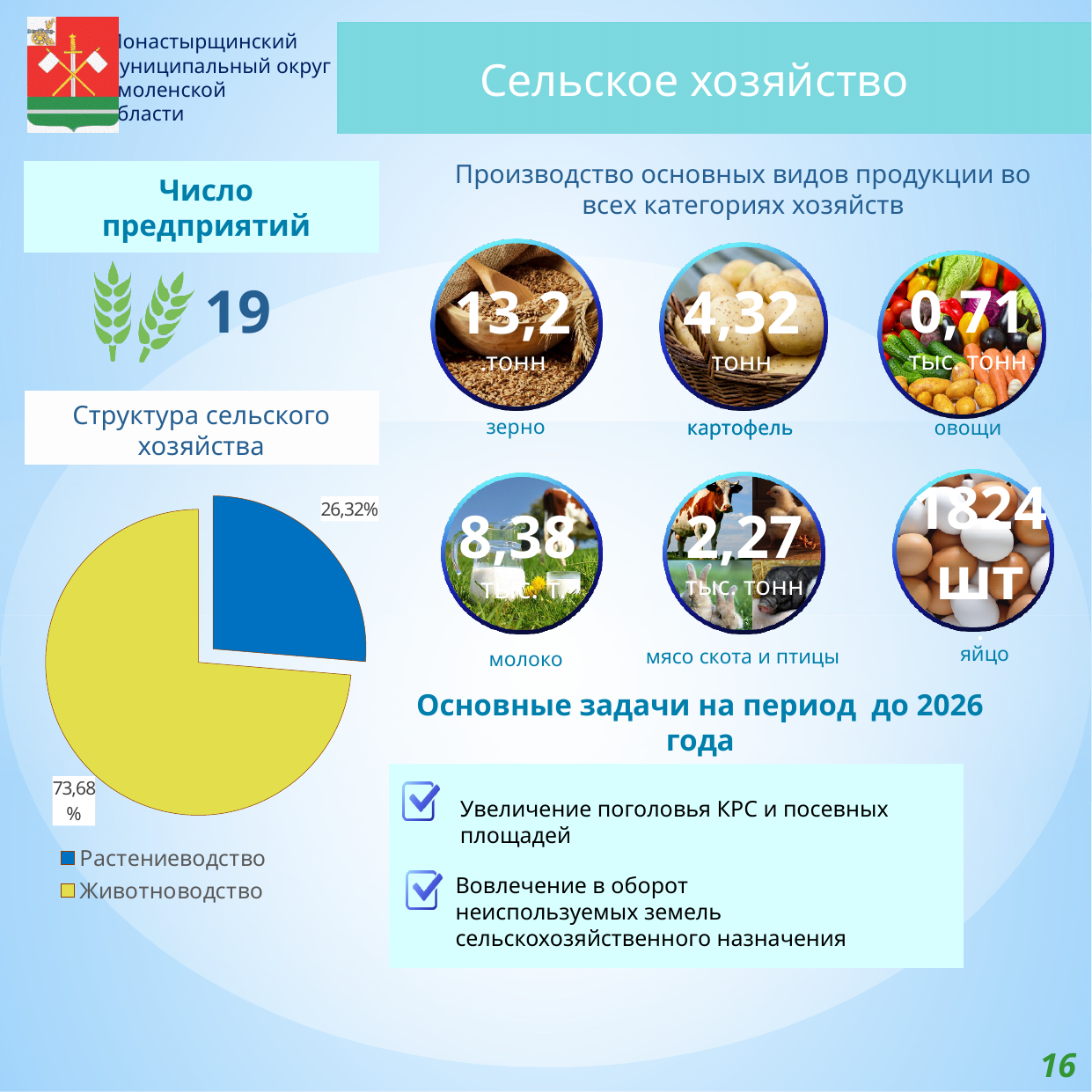
How many slices does the pie chart have? 2 Which is larger in the pie chart, Растениеводство or Животноводство? Животноводство Which category has the smallest slice in the pie chart? Растениеводство What share of the pie chart does Животноводство account for? 73,68% What colour is the Растениеводство slice in the pie chart? Blue What is the share of the yellow slice in the pie chart? 73,68% What is the title of the chart on the slide? Структура сельского хозяйства By how many percentage points does Животноводство exceed Растениеводство in the pie chart? 47,36% How many entries does the legend of the pie chart list? 2 What share of the pie chart does Растениеводство account for? 26,32% What kind of chart is shown under the heading 'Структура сельского хозяйства'? Pie chart Which category has the largest slice in the pie chart? Животноводство